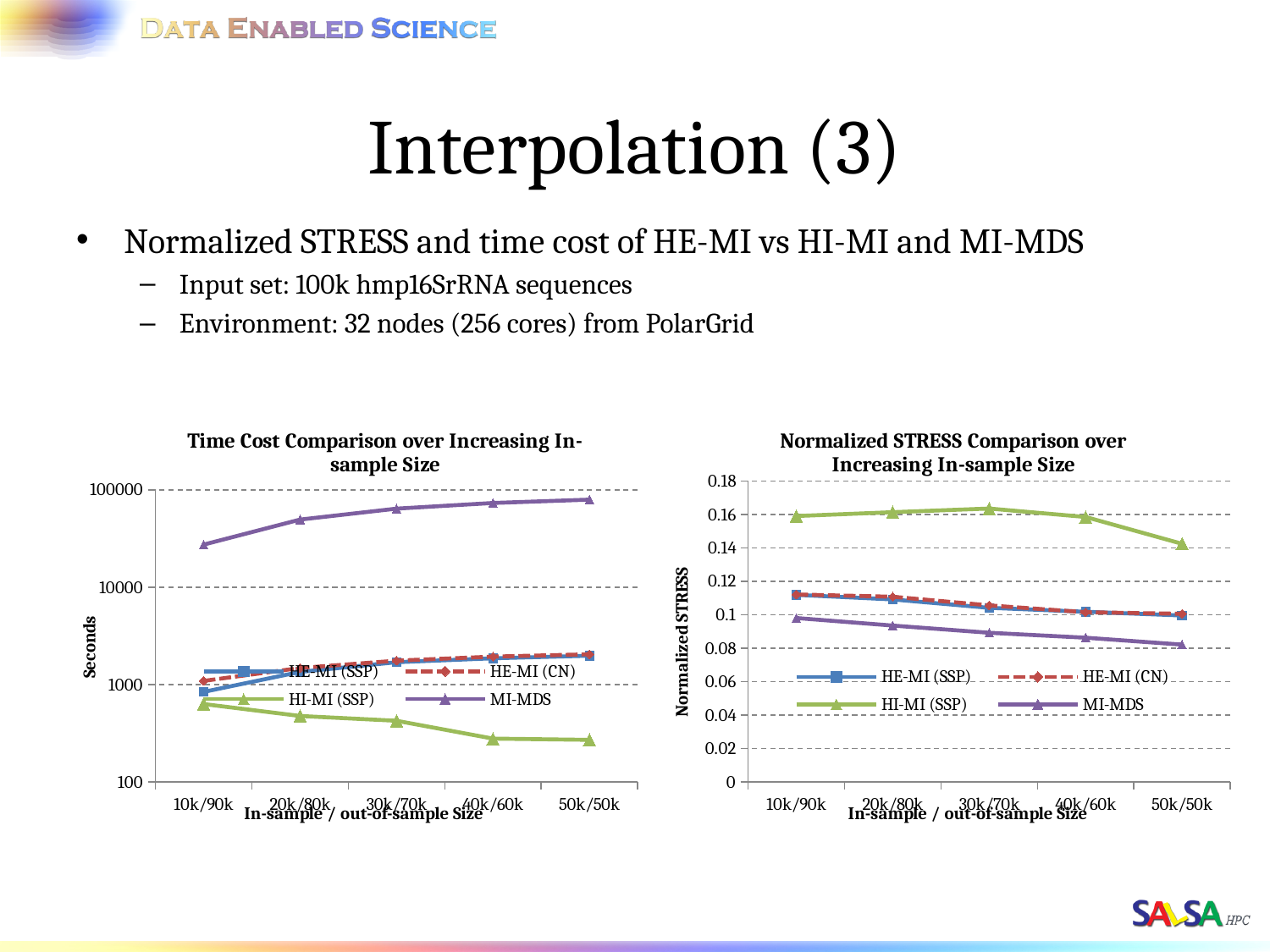
In the right chart, 'Normalized STRESS Comparison over Increasing In-sample Size', which series has the lowest normalized STRESS? MI-MDS What is the y-axis label of the left chart, 'Time Cost Comparison over Increasing In-sample Size'? Seconds In the right chart, 'Normalized STRESS Comparison over Increasing In-sample Size', is the value for MI-MDS at 50k/50k greater or less than 0.1? less How many series does the legend of the right chart, 'Normalized STRESS Comparison over Increasing In-sample Size', list? 4 In the left chart, 'Time Cost Comparison over Increasing In-sample Size', is the value for HI-MI (SSP) at 50k/50k greater or less than 1000 seconds? less How many in-sample / out-of-sample size categories are shown on the x axis of the left chart, 'Time Cost Comparison over Increasing In-sample Size'? 5 In the left chart, 'Time Cost Comparison over Increasing In-sample Size', which series has the lowest time cost at 50k/50k? HI-MI (SSP) In the left chart, 'Time Cost Comparison over Increasing In-sample Size', is the value for MI-MDS at 10k/90k greater or less than 10000 seconds? greater In the left chart, 'Time Cost Comparison over Increasing In-sample Size', which series has the highest time cost across all in-sample sizes? MI-MDS What kind of chart is the left chart, 'Time Cost Comparison over Increasing In-sample Size'? line chart In the left chart, 'Time Cost Comparison over Increasing In-sample Size', does the time cost of MI-MDS rise or fall as the in-sample size increases? rise In the right chart, 'Normalized STRESS Comparison over Increasing In-sample Size', which series has the highest normalized STRESS? HI-MI (SSP)